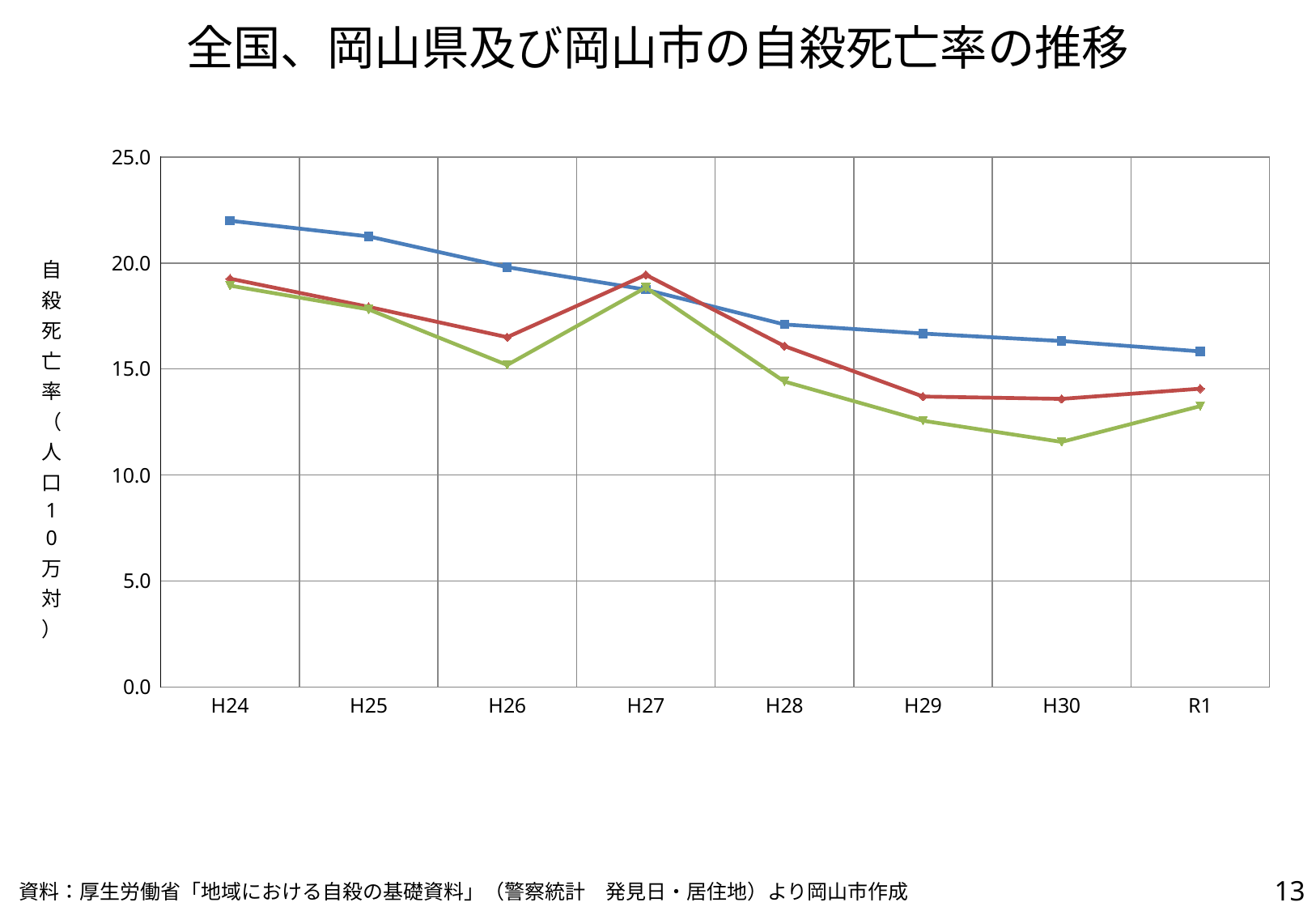
What is the title of the chart? 全国、岡山県及び岡山市の自殺死亡率の推移 At which x-axis point is the green line lowest? H30 At H28, which line is higher, the blue line or the green line? blue line Is the value of the red line at H29 greater or less than 15.0? less What kind of chart is shown on the slide? line chart Is the value of the green line at H30 greater or less than 15.0? less Does the blue line rise or fall overall from H24 to R1? fall At H26, which line is higher, the red line or the green line? red line Is the value of the blue line at R1 greater or less than 15.0? greater How many points are on the x axis of the chart? 8 At which x-axis point is the blue line highest? H24